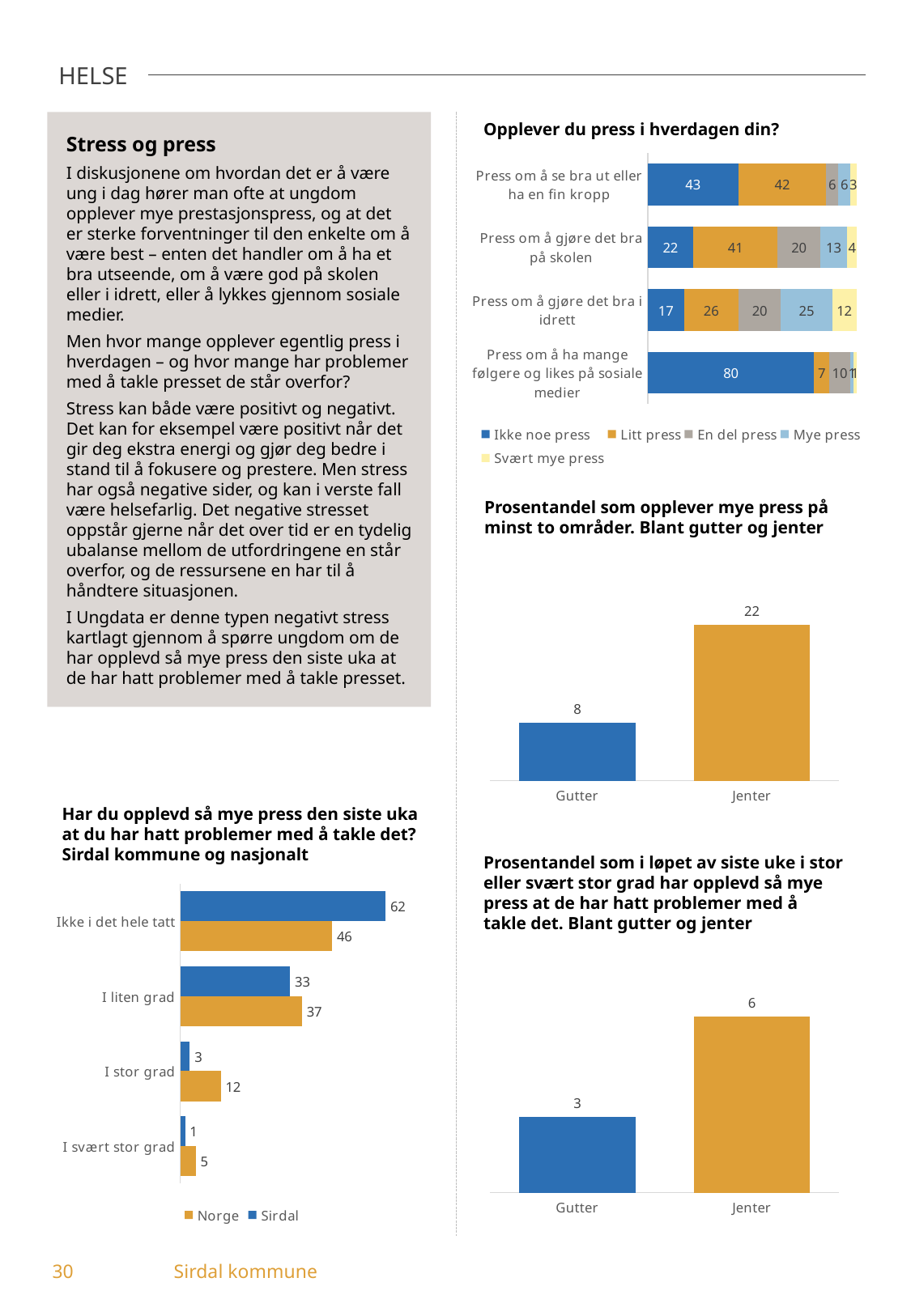
In the chart 'Opplever du press i hverdagen din?', what is the 'Ikke noe press' value for 'Press om å ha mange følgere og likes på sosiale medier'? 80 In the chart 'Prosentandel som i løpet av siste uke i stor eller svært stor grad har opplevd så mye press at de har hatt problemer med å takle det. Blant gutter og jenter', which category has the higher value, Gutter or Jenter? Jenter In the chart 'Har du opplevd så mye press den siste uka at du har hatt problemer med å takle det? Sirdal kommune og nasjonalt', how many series does the legend list? 2 In the chart 'Har du opplevd så mye press den siste uka at du har hatt problemer med å takle det? Sirdal kommune og nasjonalt', what is the difference between the Norge and Sirdal values for 'I liten grad'? 4 In the chart 'Opplever du press i hverdagen din?', how many series does the legend list? 5 What kind of chart is 'Opplever du press i hverdagen din?'? Stacked bar chart In the chart 'Prosentandel som opplever mye press på minst to områder. Blant gutter og jenter', what is the difference between the values for Jenter and Gutter? 14 In the chart 'Prosentandel som opplever mye press på minst to områder. Blant gutter og jenter', what is the value for Jenter? 22 In the chart 'Opplever du press i hverdagen din?', what is the 'Litt press' value for 'Press om å gjøre det bra på skolen'? 41 In the chart 'Har du opplevd så mye press den siste uka at du har hatt problemer med å takle det? Sirdal kommune og nasjonalt', what is the Norge value for 'I stor grad'? 12 In the chart 'Har du opplevd så mye press den siste uka at du har hatt problemer med å takle det? Sirdal kommune og nasjonalt', what is the Sirdal value for 'Ikke i det hele tatt'? 62 In the chart 'Prosentandel som i løpet av siste uke i stor eller svært stor grad har opplevd så mye press at de har hatt problemer med å takle det. Blant gutter og jenter', what is the value for Gutter? 3